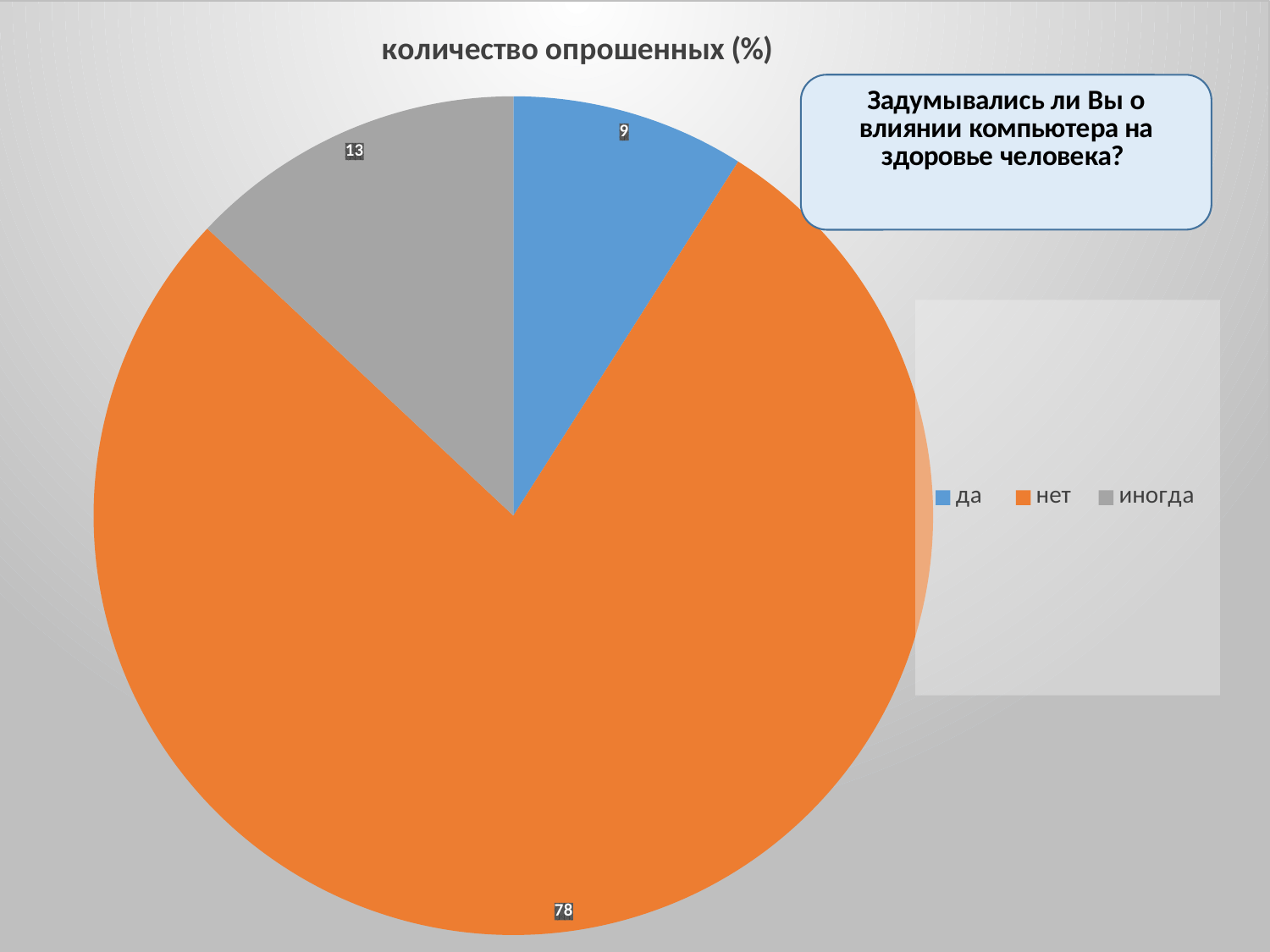
What is the title of the chart? количество опрошенных (%) What is the difference between the values for "нет" and "иногда"? 65 Which is larger, the value for "иногда" or the value for "да"? иногда Which category has the smallest slice? да What is the value for the slice "нет"? 78 What is the value for the slice "да"? 9 Which category has the largest slice? нет What type of chart is shown on the slide? pie chart How many slices does the pie chart have? 3 What is the value for the slice "иногда"? 13 What share of the pie does the "нет" slice represent? 78% How many entries does the legend list? 3